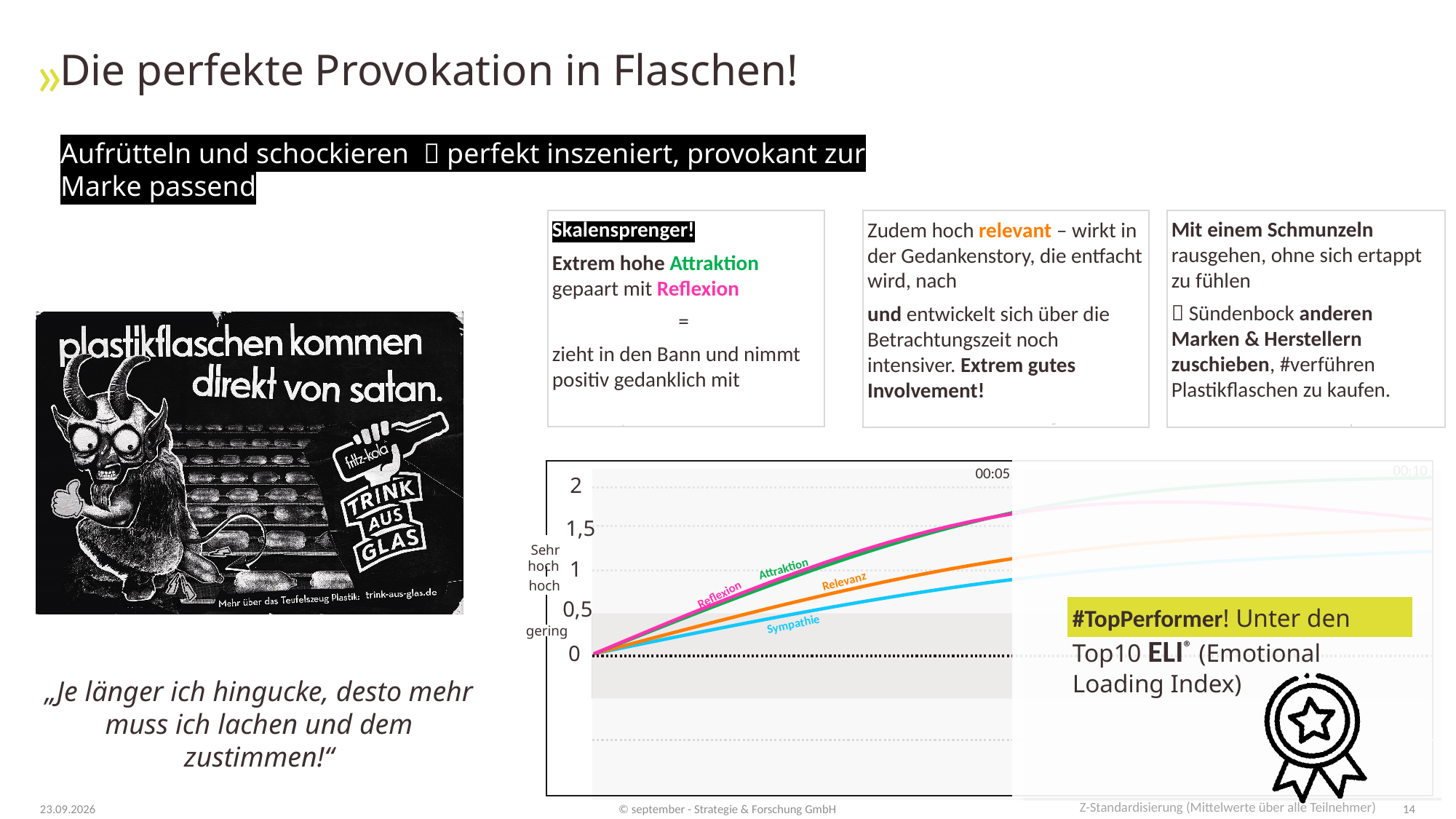
At what value do all four lines start at the left edge of the chart? 0 At the 00:05 mark, is the value for Relevanz greater or less than 1? greater At the 00:05 mark, is the value for Sympathie greater or less than 0,5? greater At the 00:05 mark, is the value for Attraktion greater or less than 1? greater At the 00:05 mark, which is larger: Relevanz or Sympathie? Relevanz What colour is the Sympathie line in the chart? blue At the 00:05 mark, which is larger: Attraktion or Sympathie? Attraktion How many series (lines) are labelled in the chart? 4 Which labelled line has the lowest values in the chart? Sympathie What kind of chart is shown on the slide? line chart Do the values of the lines rise or fall over time along the x axis? rise